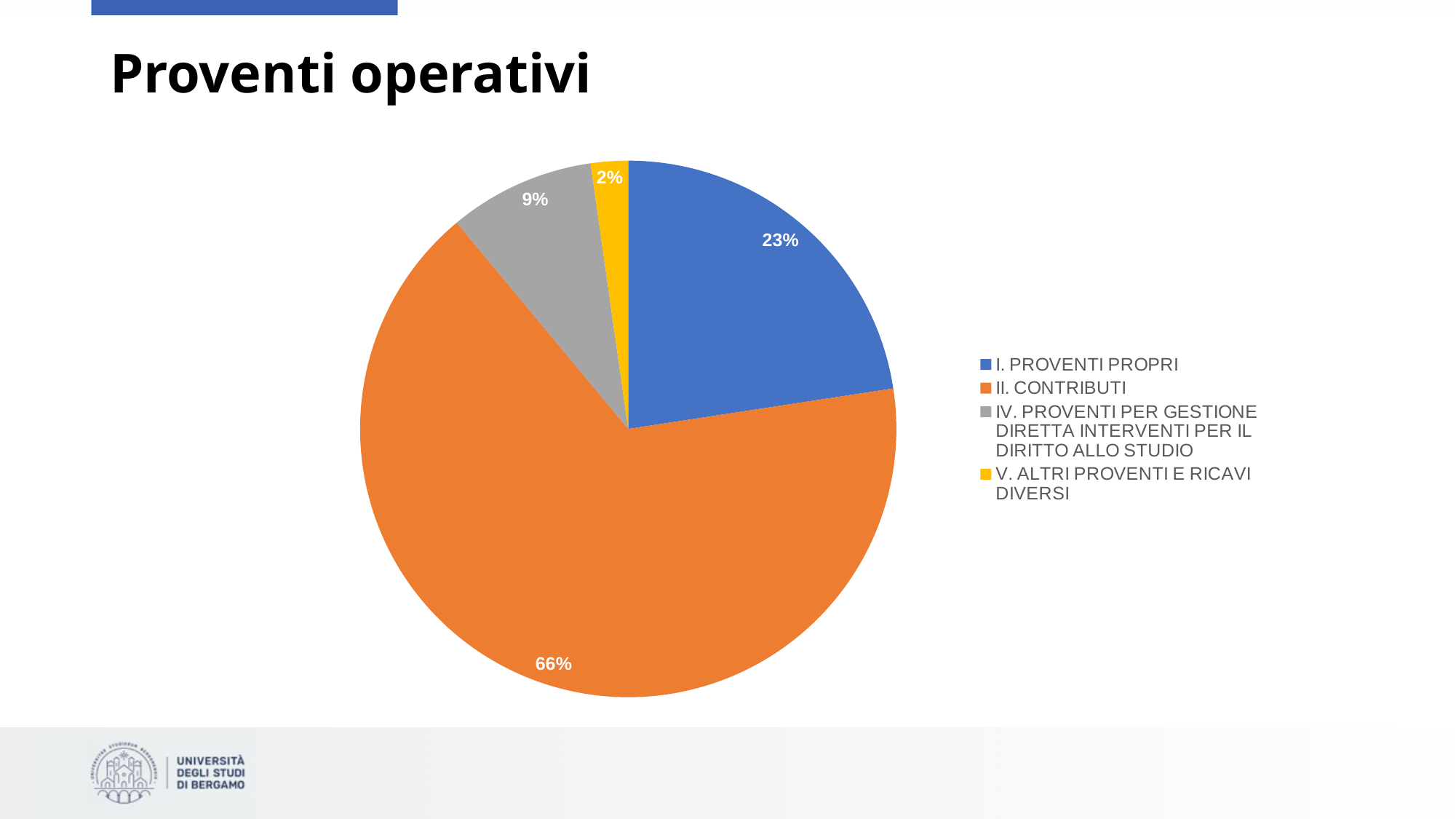
What is the difference in percentage points between II. CONTRIBUTI and I. PROVENTI PROPRI? 43 What type of chart is shown on the slide? pie chart What share of the pie does IV. PROVENTI PER GESTIONE DIRETTA INTERVENTI PER IL DIRITTO ALLO STUDIO represent? 9% Which is larger, the slice for I. PROVENTI PROPRI or the slice for IV. PROVENTI PER GESTIONE DIRETTA INTERVENTI PER IL DIRITTO ALLO STUDIO? I. PROVENTI PROPRI What share of the pie does V. ALTRI PROVENTI E RICAVI DIVERSI represent? 2% What share of the pie does I. PROVENTI PROPRI represent? 23% What is the title of the slide containing the chart? Proventi operativi Which category has the smallest slice of the pie? V. ALTRI PROVENTI E RICAVI DIVERSI Which category has the largest slice of the pie? II. CONTRIBUTI What colour is the slice for II. CONTRIBUTI? orange How many categories does the pie chart have? 4